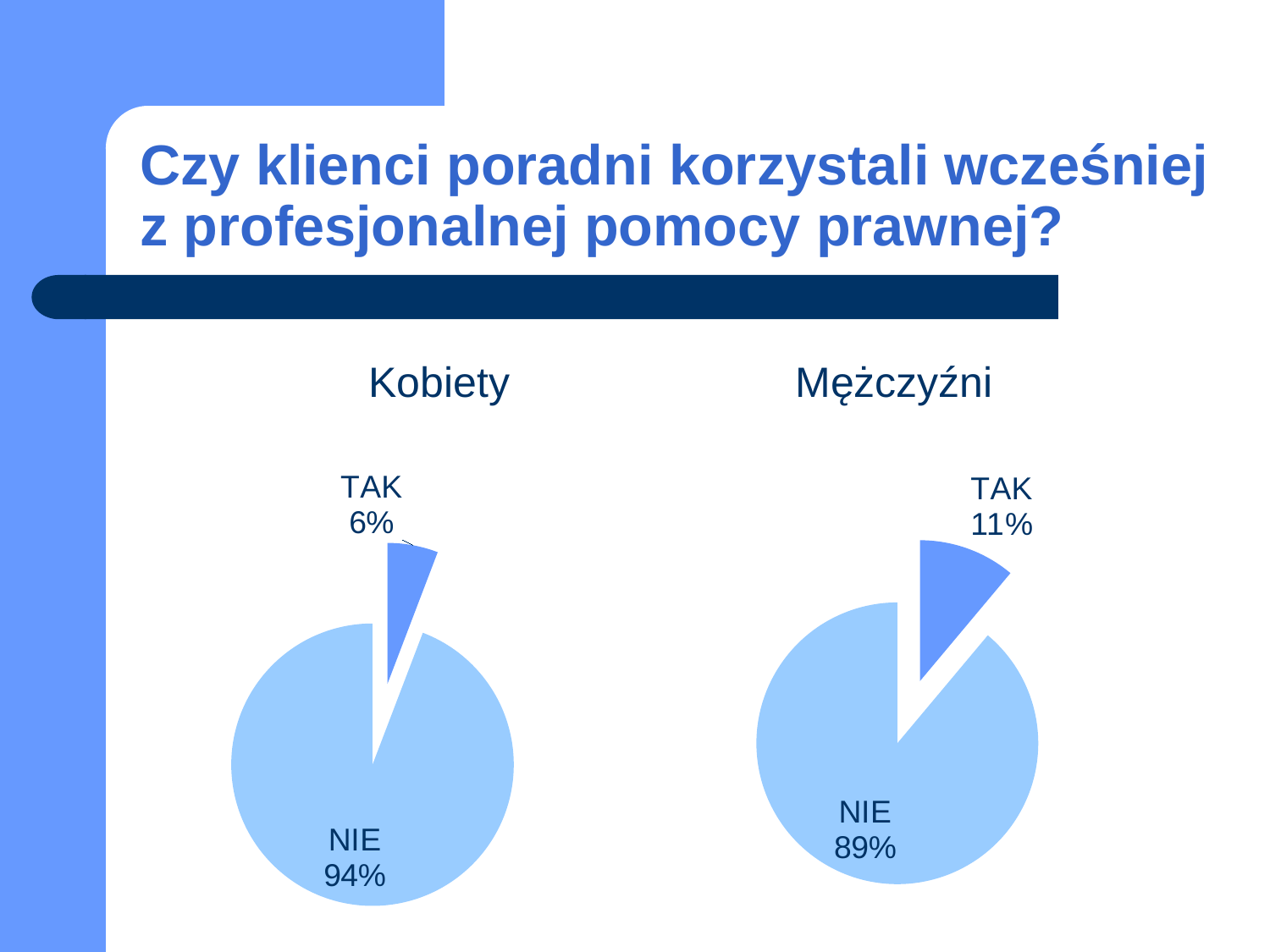
In the Mężczyźni chart, which slice is the smallest? TAK In the Mężczyźni chart, what share of the pie is TAK? 11% In the Kobiety chart, what share of the pie is NIE? 94% In the Mężczyźni chart, what is the difference between the NIE and TAK shares? 78% What kind of chart is the Kobiety chart? Pie chart How many slices does the Mężczyźni chart have? 2 In the Kobiety chart, what is the difference between the NIE and TAK shares? 88% How many pie charts are shown on the slide? 2 In the Mężczyźni chart, what share of the pie is NIE? 89% In the Kobiety chart, which slice is the largest? NIE Which is larger: the TAK share in the Kobiety chart or the TAK share in the Mężczyźni chart? Mężczyźni